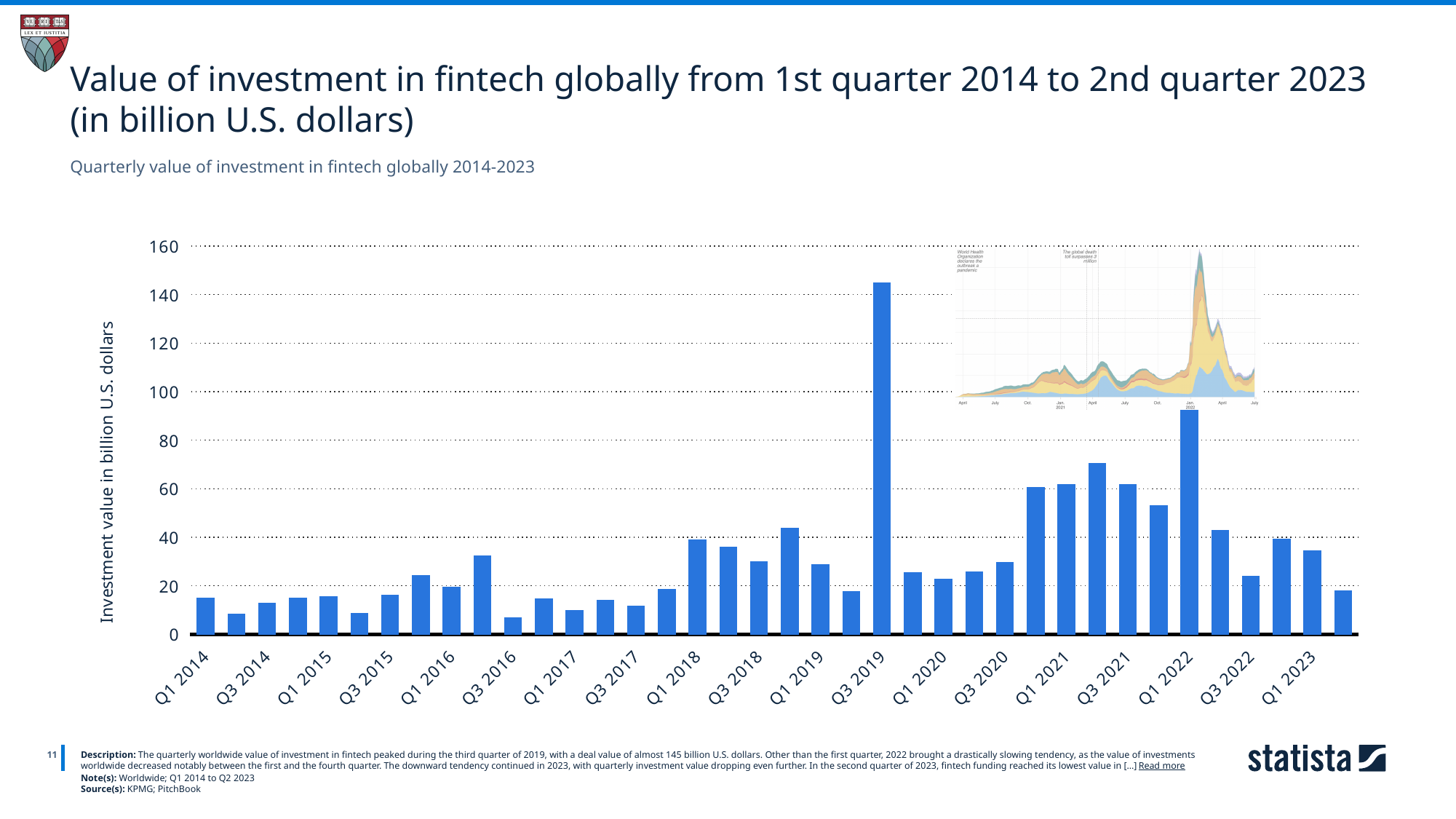
What is the label of the vertical axis? Investment value in billion U.S. dollars How many quarterly bars are plotted in the chart? 38 Is the value for Q3 2016 greater or less than 20? less Do the values generally rise or fall from Q1 2022 to Q2 2023? fall Which quarter has the highest value of fintech investment? Q3 2019 Which is larger, the value for Q1 2018 or the value for Q1 2017? Q1 2018 What kind of chart is shown on the slide? bar chart Is the value for Q1 2022 greater or less than 80? greater Is the value for Q3 2019 greater or less than 120? greater Which is larger, the value for Q1 2022 or the value for Q3 2021? Q1 2022